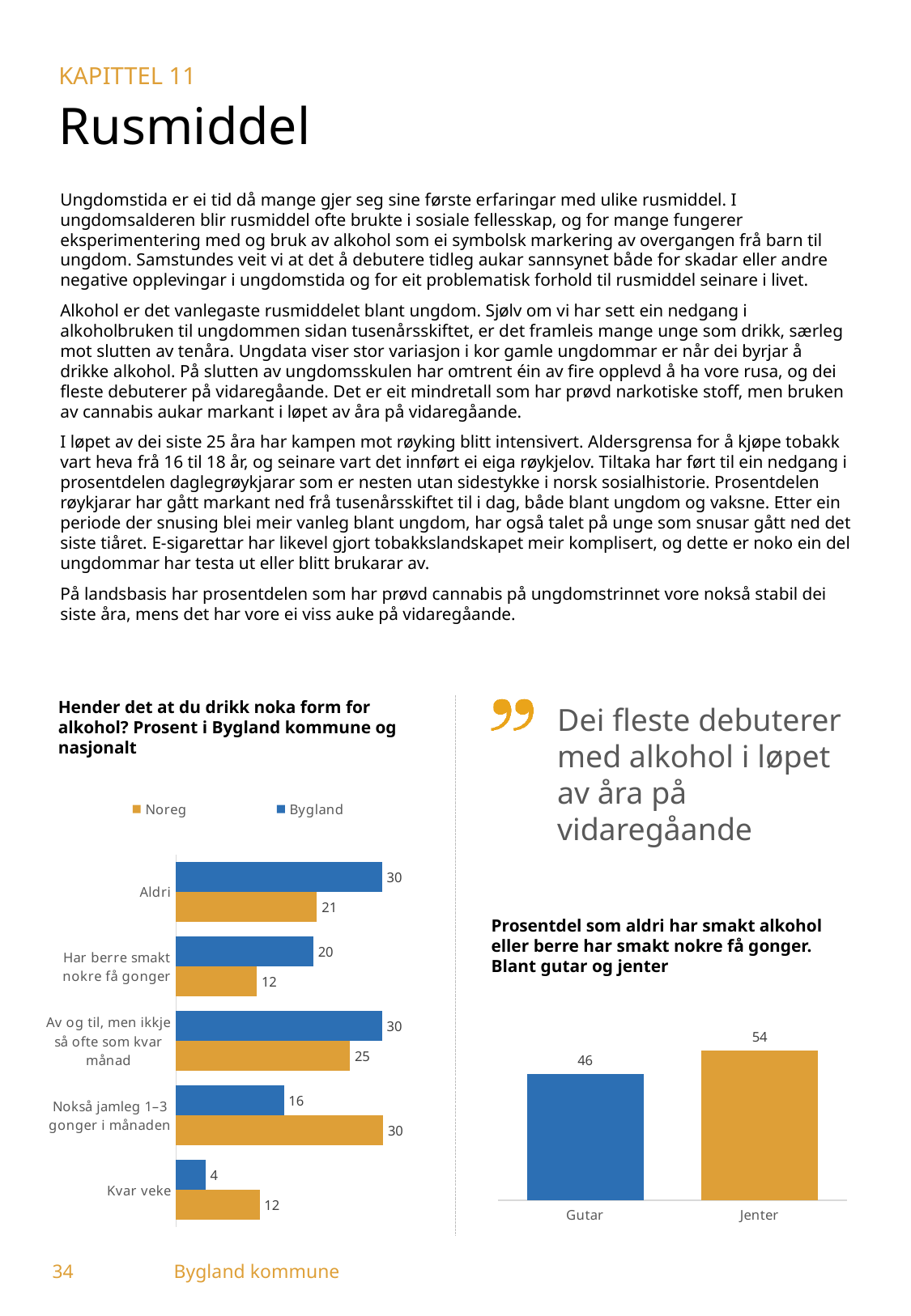
In the chart 'Prosentdel som aldri har smakt alkohol eller berre har smakt nokre få gonger', what is the value for Jenter? 54 In the chart 'Hender det at du drikk noka form for alkohol?', what is the Bygland value for 'Aldri'? 30 In the chart 'Hender det at du drikk noka form for alkohol?', which is larger for 'Nokså jamleg 1–3 gonger i månaden', Noreg or Bygland? Noreg In the chart 'Hender det at du drikk noka form for alkohol?', what is the Noreg value for 'Kvar veke'? 12 In the chart 'Prosentdel som aldri har smakt alkohol eller berre har smakt nokre få gonger', what is the difference between Jenter and Gutar? 8 What kind of chart is 'Hender det at du drikk noka form for alkohol?'? Bar chart In the chart 'Hender det at du drikk noka form for alkohol?', which colour represents the Noreg series? Orange In the chart 'Hender det at du drikk noka form for alkohol?', what is the difference between the Bygland and Noreg values for 'Har berre smakt nokre få gonger'? 8 How many categories are shown in the chart 'Hender det at du drikk noka form for alkohol?'? 5 In the chart 'Hender det at du drikk noka form for alkohol?', which category has the lowest Bygland value? Kvar veke In the chart 'Hender det at du drikk noka form for alkohol?', what is the Noreg value for 'Nokså jamleg 1–3 gonger i månaden'? 30 How many series does the legend list in the chart 'Hender det at du drikk noka form for alkohol?'? 2